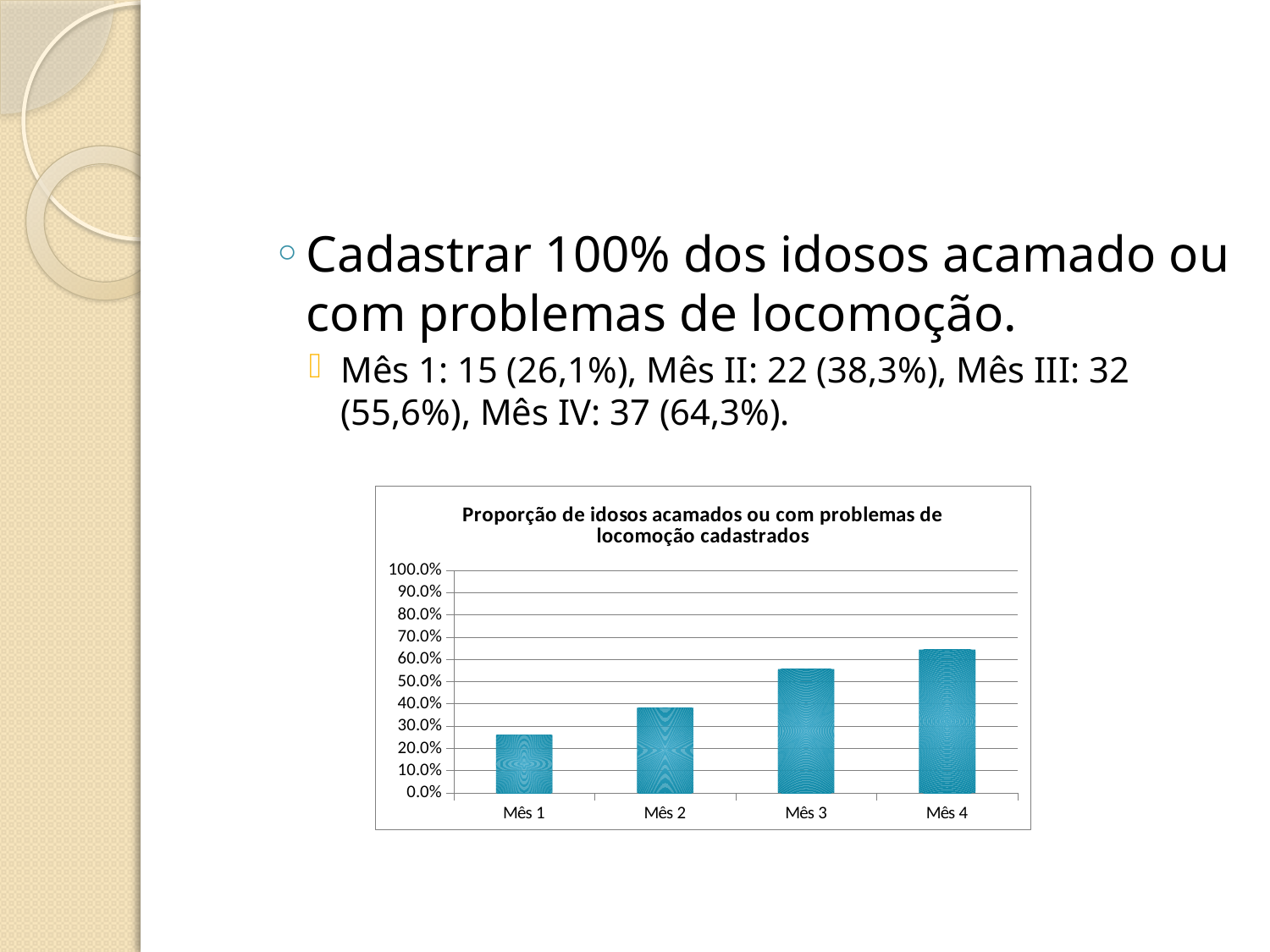
What is the title of the chart? Proporção de idosos acamados ou com problemas de locomoção cadastrados Is the value for Mês 4 greater or less than 70.0%? less Is the value for Mês 3 greater or less than 50.0%? greater Do the values rise or fall from Mês 1 to Mês 4? rise What kind of chart is shown on the slide? bar chart Which month has the lowest bar on the chart? Mês 1 Is the value for Mês 2 greater or less than 30.0%? greater Which month has the highest bar on the chart? Mês 4 How many categories (months) are plotted on the chart? 4 What is the maximum value shown on the vertical axis of the chart? 100.0% Which is larger, the value for Mês 2 or the value for Mês 3? Mês 3